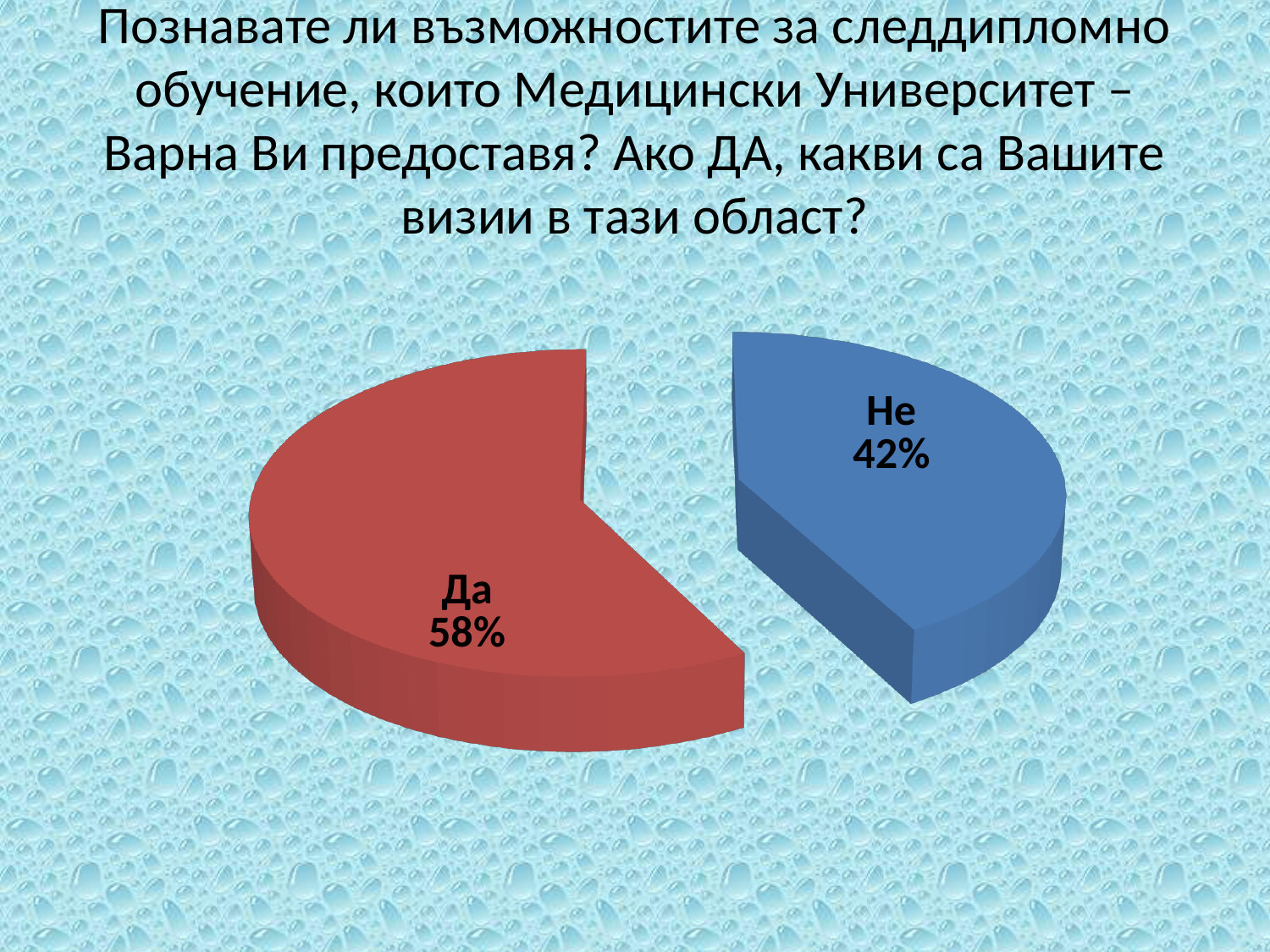
Which slice is the smallest in the pie chart? Не What kind of chart is shown on the slide? pie chart Which is larger, the "Да" slice or the "Не" slice? Да What colour is the "Да" slice? red What is the difference in percentage points between the "Да" and "Не" slices? 16% Is the value for "Не" greater or less than 50%? less How many slices does the pie chart have? 2 What share of the pie does the "Да" slice represent? 58% Which slice is the largest in the pie chart? Да What colour is the "Не" slice? blue Is the value for "Да" greater or less than 50%? greater What share of the pie does the "Не" slice represent? 42%